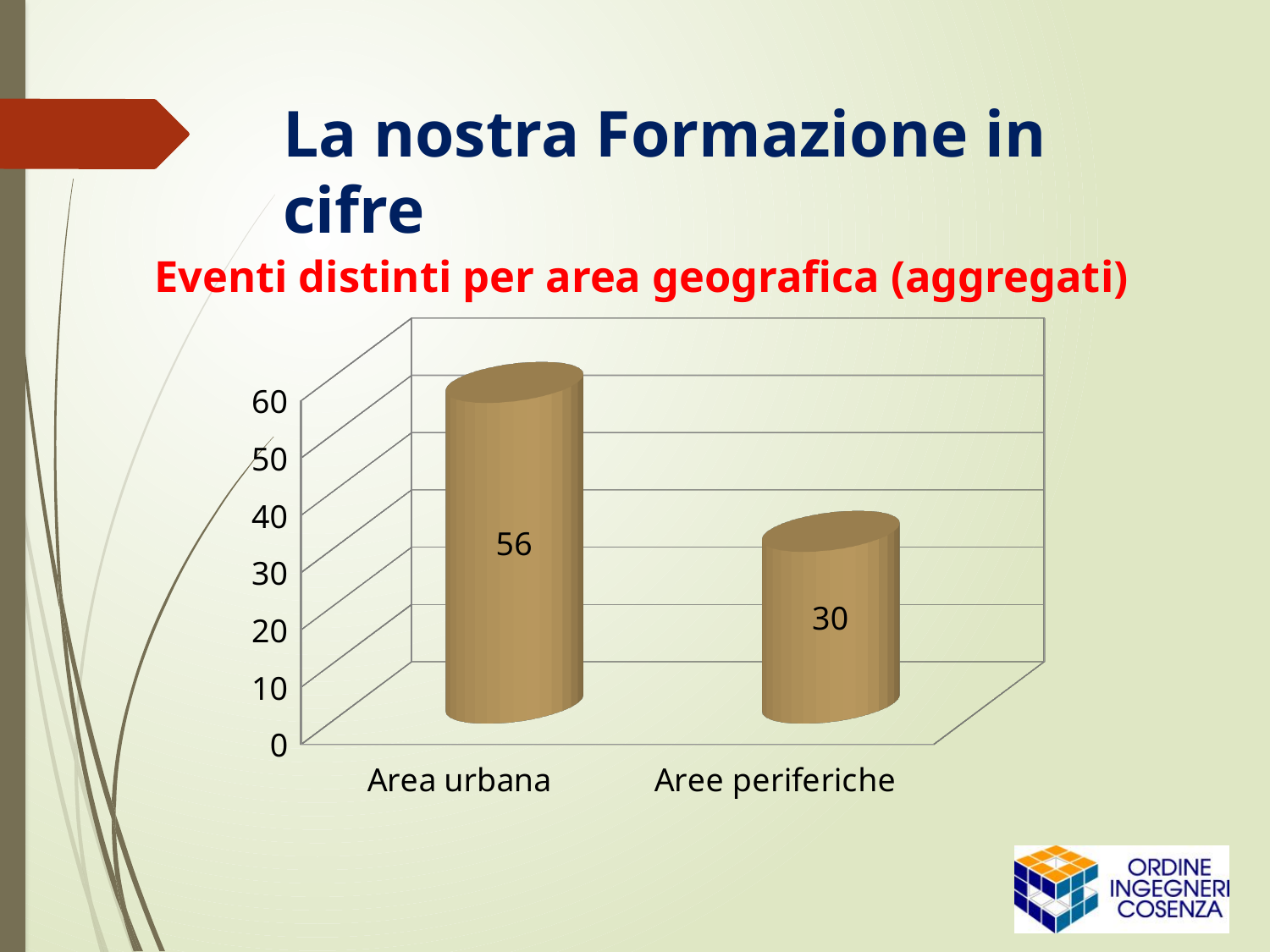
Which is larger, the value for Area urbana or the value for Aree periferiche? Area urbana Which category has the lowest value? Aree periferiche What is the title of the chart? Eventi distinti per area geografica (aggregati) Which category has the highest value? Area urbana What is the value for Area urbana? 56 How many categories are shown in the chart? 2 Is the value for Aree periferiche greater or less than 40? less What is the highest value shown on the vertical axis? 60 What kind of chart is shown on the slide? bar chart What is the difference between the values for Area urbana and Aree periferiche? 26 What is the value for Aree periferiche? 30 Is the value for Area urbana greater or less than 50? greater